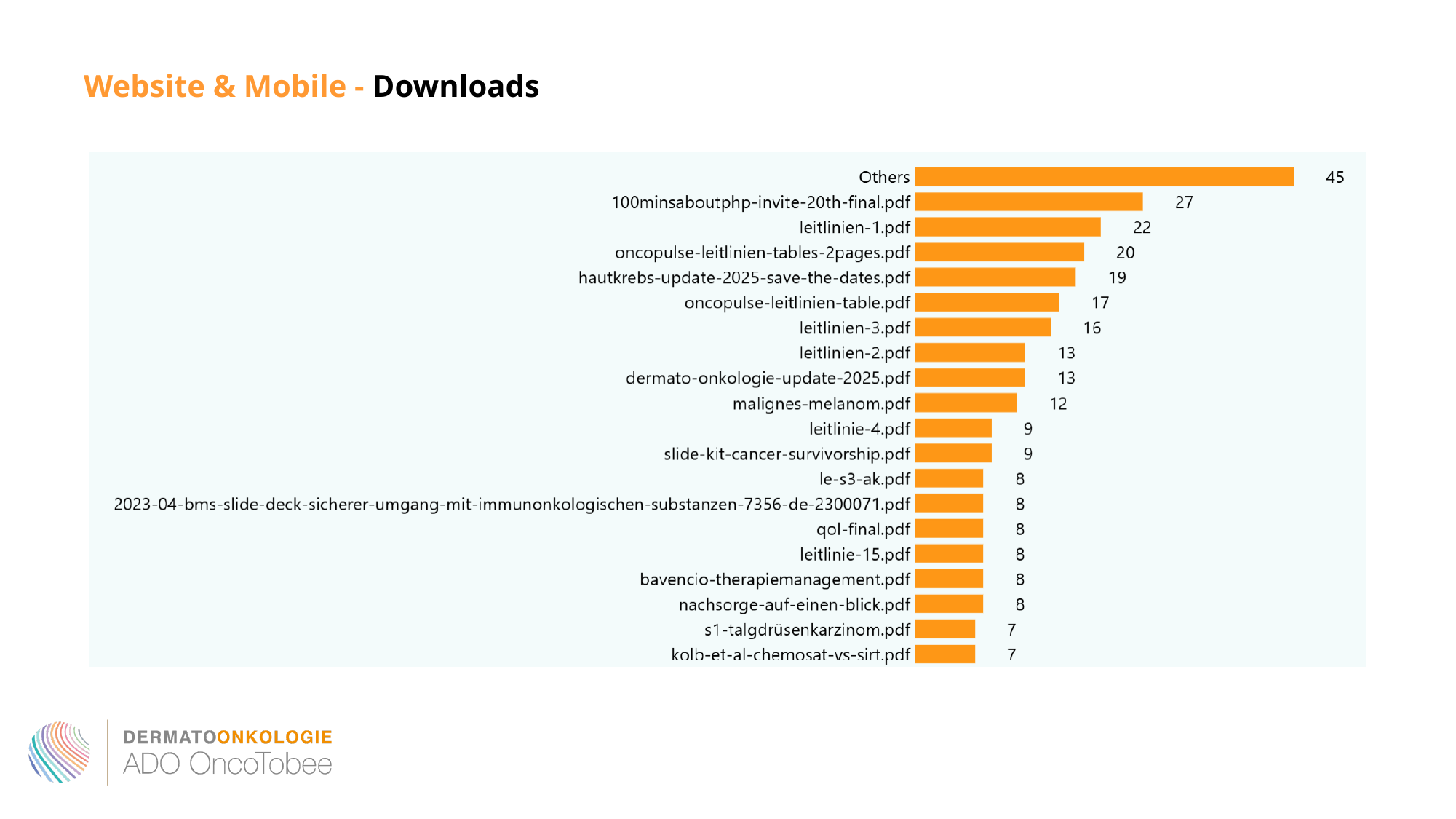
How many categories are shown in the chart? 20 What is the value for malignes-melanom.pdf? 12 What is the value for leitlinien-1.pdf? 22 What is the difference between the values for Others and oncopulse-leitlinien-tables-2pages.pdf? 25 What is the value for Others? 45 What is the value for hautkrebs-update-2025-save-the-dates.pdf? 19 Which category has the highest value? Others What colour are the bars in the chart? Orange Which is larger, the value for leitlinien-3.pdf or the value for oncopulse-leitlinien-table.pdf? oncopulse-leitlinien-table.pdf Which is larger, the value for leitlinie-4.pdf or the value for s1-talgdrüsenkarzinom.pdf? leitlinie-4.pdf What kind of chart is shown on the slide? Bar chart What is the difference between the values for 100minsaboutphp-invite-20th-final.pdf and leitlinien-1.pdf? 5